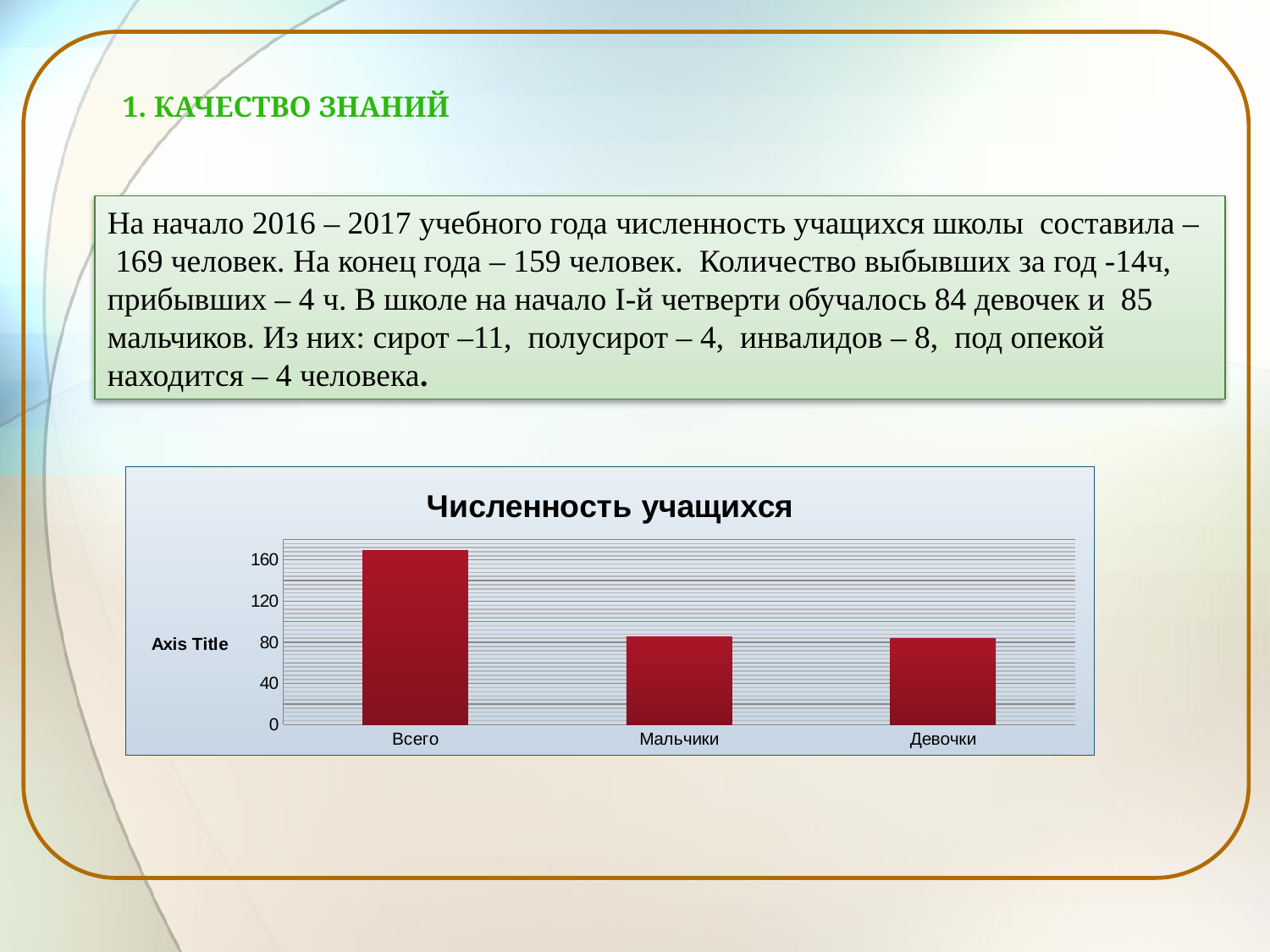
How many categories are shown on the x axis of the "Численность учащихся" chart? 3 Is the value for Всего greater or less than 160? greater What kind of chart is shown under the title "Численность учащихся"? bar chart Is the value for Всего greater or less than 120? greater Is the value for Мальчики greater or less than 120? less What is the title of the chart on the slide? Численность учащихся Which is larger, the value for Всего or the value for Мальчики? Всего What text is shown as the vertical axis title of the chart? Axis Title Which category has the highest bar in the "Численность учащихся" chart? Всего Which is larger, the value for Всего or the value for Девочки? Всего